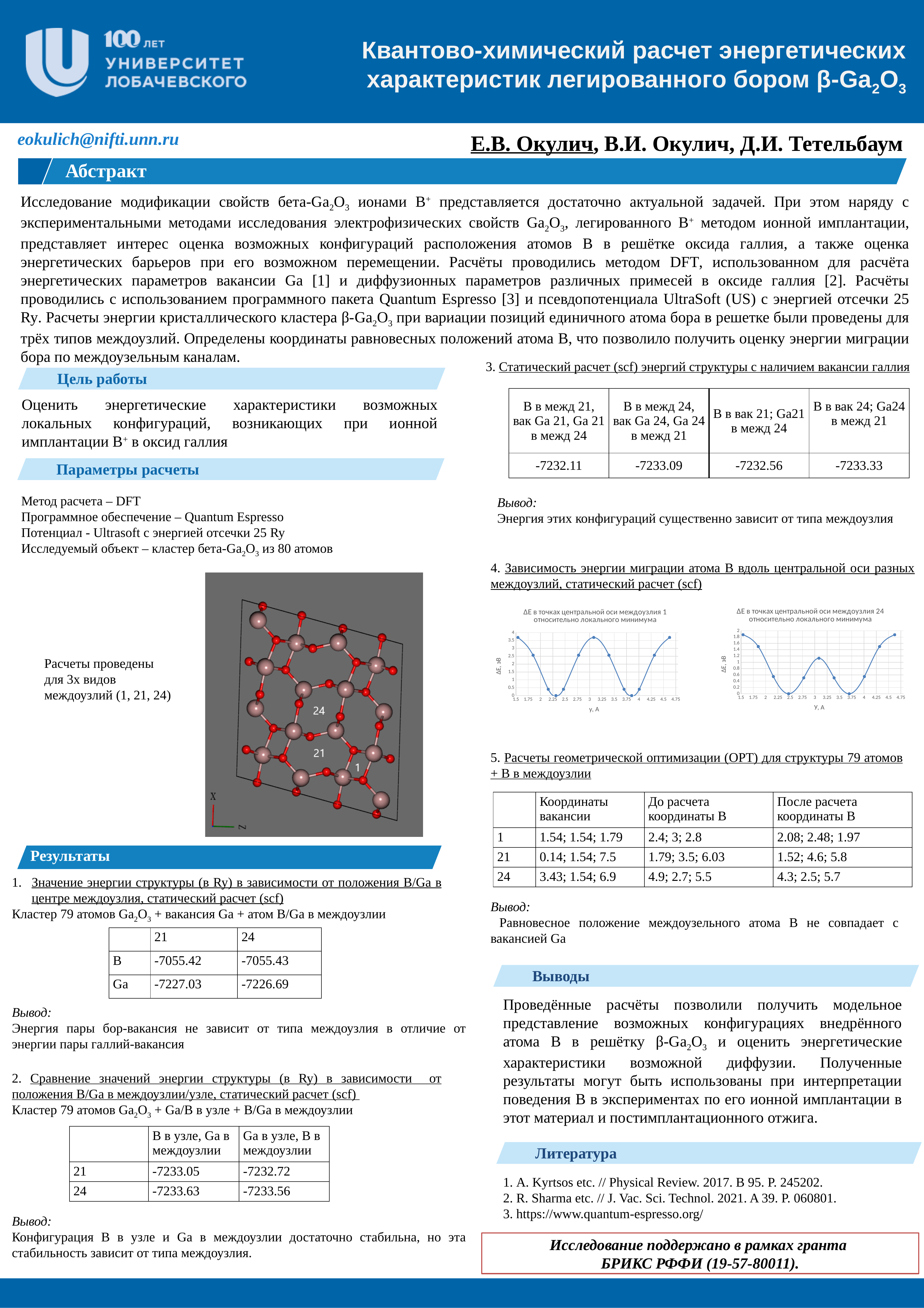
In the right chart (междоузлие 24), which is larger: the value at y = 1.5 Å or the value at y = 3 Å? y = 1.5 Å In the left chart (междоузлие 1), is the value at y = 2.25 Å greater or less than 1? less What is the label of the vertical axis on the two line charts? ΔE, эВ What kind of chart is the right chart titled 'ΔE в точках центральной оси междоузлия 24 относительно локального минимума'? line chart In the right chart (междоузлие 24), is the value at y = 3.75 Å greater or less than 0.5? less What kind of chart is the left chart titled 'ΔE в точках центральной оси междоузлия 1 относительно локального минимума'? line chart In the left chart (междоузлие 1), do the values rise or fall as y goes from 1.5 Å to 2.25 Å? fall In the right chart (междоузлие 24), is the value at y = 2.5 Å greater or less than 0.5? less In the left chart (междоузлие 1), which is larger: the value at y = 1.5 Å or the value at y = 2.25 Å? y = 1.5 Å